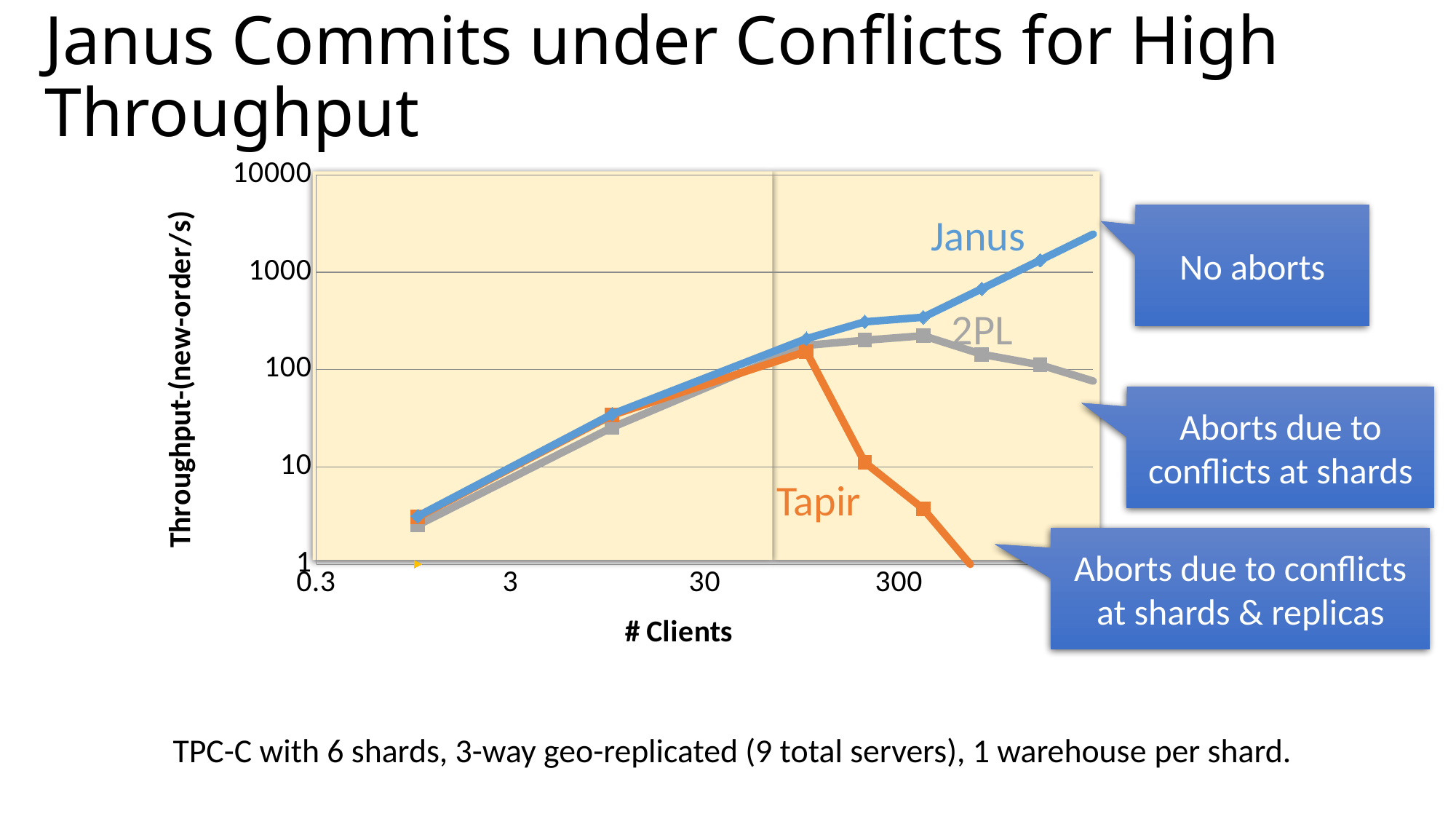
What kind of chart is shown on the slide? line chart At 300 clients, which series has higher throughput, Janus or Tapir? Janus Which series has the lowest throughput at the right-hand end of the chart? Tapir At the highest number of clients plotted, which series has higher throughput, Janus or 2PL? Janus Which series reaches the highest throughput on the chart? Janus Is the throughput of Janus at its rightmost plotted point greater or less than 1000? greater How does the Tapir throughput change as the number of clients increases? it rises, then falls sharply Is the throughput of 2PL at its rightmost plotted point greater or less than 100? less How many data series are plotted on the chart? 3 Is the throughput of Tapir at its final plotted point greater or less than 10? less What is the label of the x axis? # Clients How does the Janus throughput change as the number of clients increases? it rises